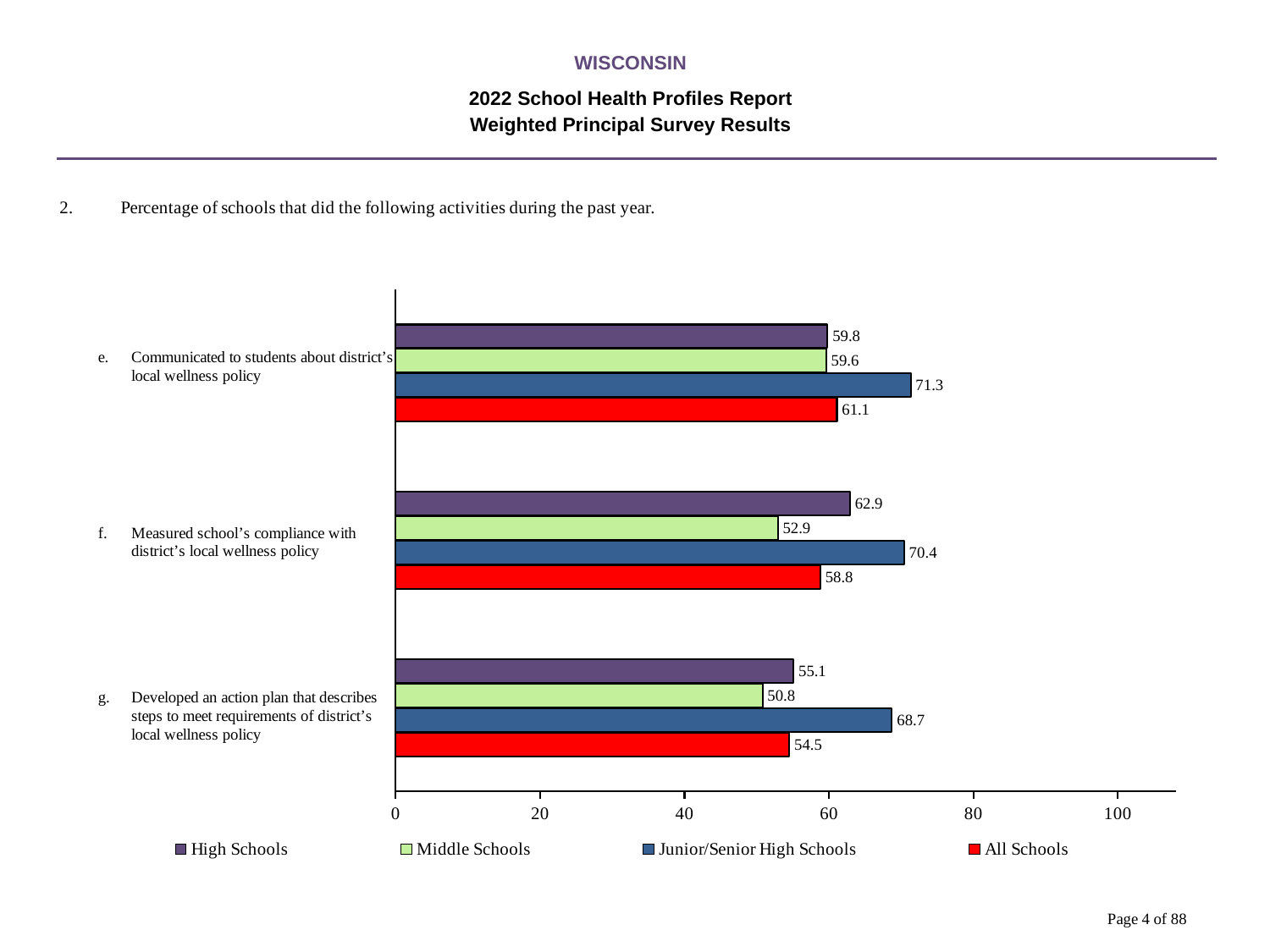
Which school type has the lowest value for 'Developed an action plan that describes steps to meet requirements of district's local wellness policy'? Middle Schools Which school type has the highest value for 'Measured school's compliance with district's local wellness policy'? Junior/Senior High Schools Is the Junior/Senior High Schools value for 'Developed an action plan that describes steps to meet requirements of district's local wellness policy' greater or less than 60? greater Which is larger for 'Communicated to students about district's local wellness policy': the All Schools value or the High Schools value? All Schools Which colour represents All Schools in the legend? red What is the value for Middle Schools for 'Measured school's compliance with district's local wellness policy'? 52.9 What is the difference between the High Schools and Middle Schools values for 'Measured school's compliance with district's local wellness policy'? 10.0 What kind of chart is shown on the slide? bar chart What is the value for Junior/Senior High Schools for 'Communicated to students about district's local wellness policy'? 71.3 What is the value for All Schools for 'Developed an action plan that describes steps to meet requirements of district's local wellness policy'? 54.5 How many activities (categories) are shown on the chart? 3 How many series does the legend list? 4